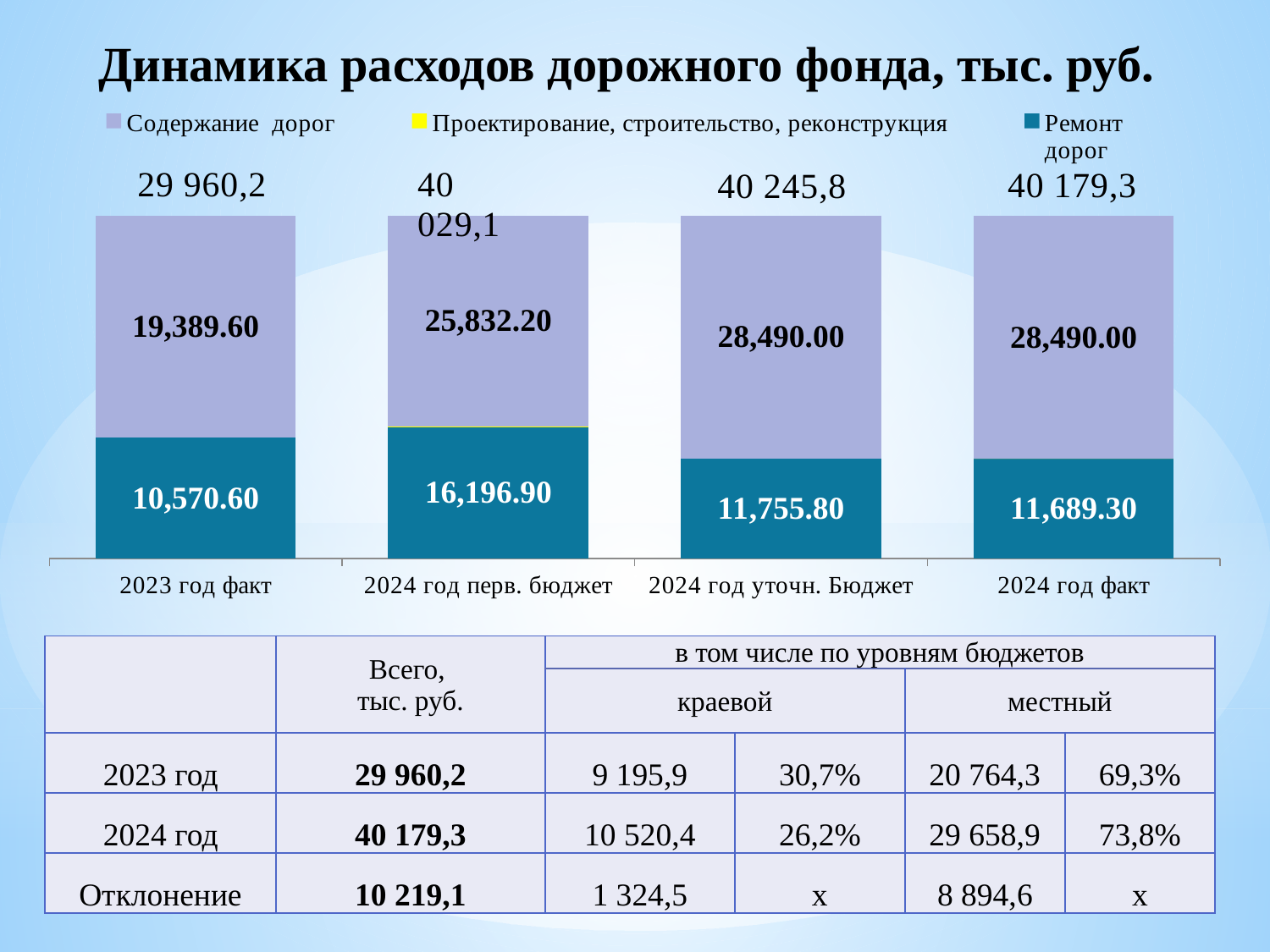
What is the difference between the Содержание дорог values for 2024 год перв. бюджет and 2023 год факт? 6,442.60 What is the total shown above the bar for 2024 год уточн. Бюджет? 40 245,8 What is the value of Содержание дорог for 2023 год факт? 19,389.60 What is the value of Ремонт дорог for 2024 год перв. бюджет? 16,196.90 Which category has the highest value for Ремонт дорог? 2024 год перв. бюджет What is the value of Ремонт дорог for 2024 год факт? 11,689.30 How many series does the chart legend list? 3 Which is larger: Ремонт дорог for 2024 год уточн. Бюджет or for 2024 год факт? 2024 год уточн. Бюджет What is the title of the chart? Динамика расходов дорожного фонда, тыс. руб. How many categories are shown along the x axis of the chart? 4 Which category has the lowest total expenditure? 2023 год факт What kind of chart is shown on the slide? stacked bar chart